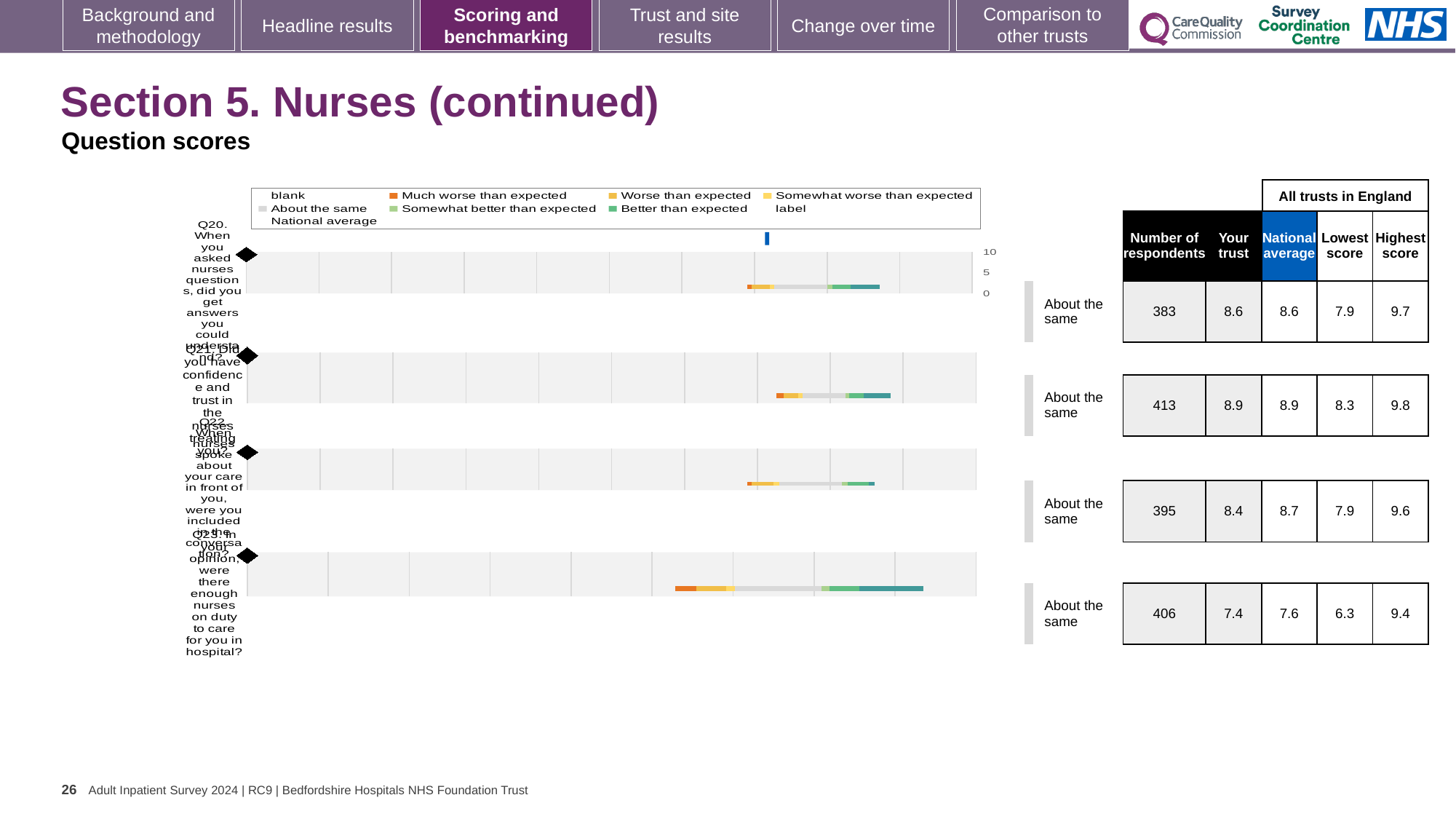
What benchmark category is shown next to each of the four questions in the chart? About the same What is the highest tick value shown on the chart's score axis? 10 According to the table beside the chart, what is the difference between the national average and the 'Your trust' score for Q22? 0.3 According to the table beside the chart, how many respondents answered Q21? 413 According to the table beside the chart, what is the 'Your trust' score for Q23 (enough nurses on duty)? 7.4 According to the table beside the chart, which question has the lowest 'Your trust' score? Q23 According to the table beside the chart, for Q23 is the 'Your trust' score or the national average larger? National average What colour does the legend use for 'Much worse than expected'? orange According to the table beside the chart, what is the highest score among all trusts in England for Q20? 9.7 How many questions (rows) are plotted in the chart? 4 What kind of chart is used to show the question scores on this slide? bar chart According to the table beside the chart, which question has the highest 'Your trust' score? Q21